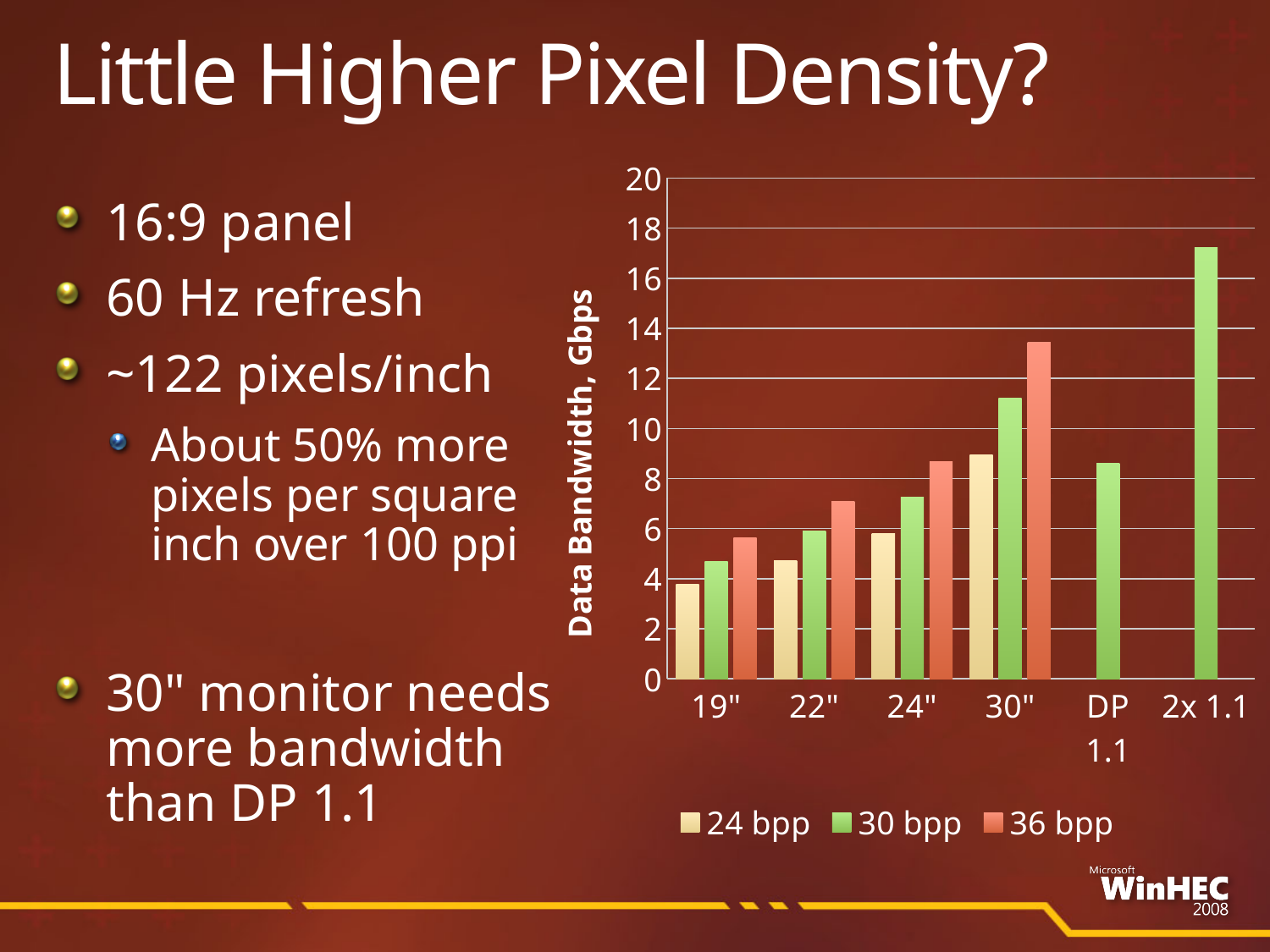
Which is larger: the 36 bpp value for 30" or the 30 bpp value for DP 1.1? 36 bpp value for 30" How many categories are shown along the x axis of the chart? 6 Is the 30 bpp value for 2x 1.1 greater or less than 16? greater Is the 30 bpp value for DP 1.1 greater or less than 10? less Is the 36 bpp value for 30" greater or less than 12? greater What is the label of the vertical axis of the chart? Data Bandwidth, Gbps How many series does the chart legend list? 3 Which category has the tallest bar in the chart? 2x 1.1 Which category has the lowest 24 bpp bar? 19" Do the 30 bpp values rise or fall from 19" to 30"? rise What kind of chart is shown on the slide? bar chart